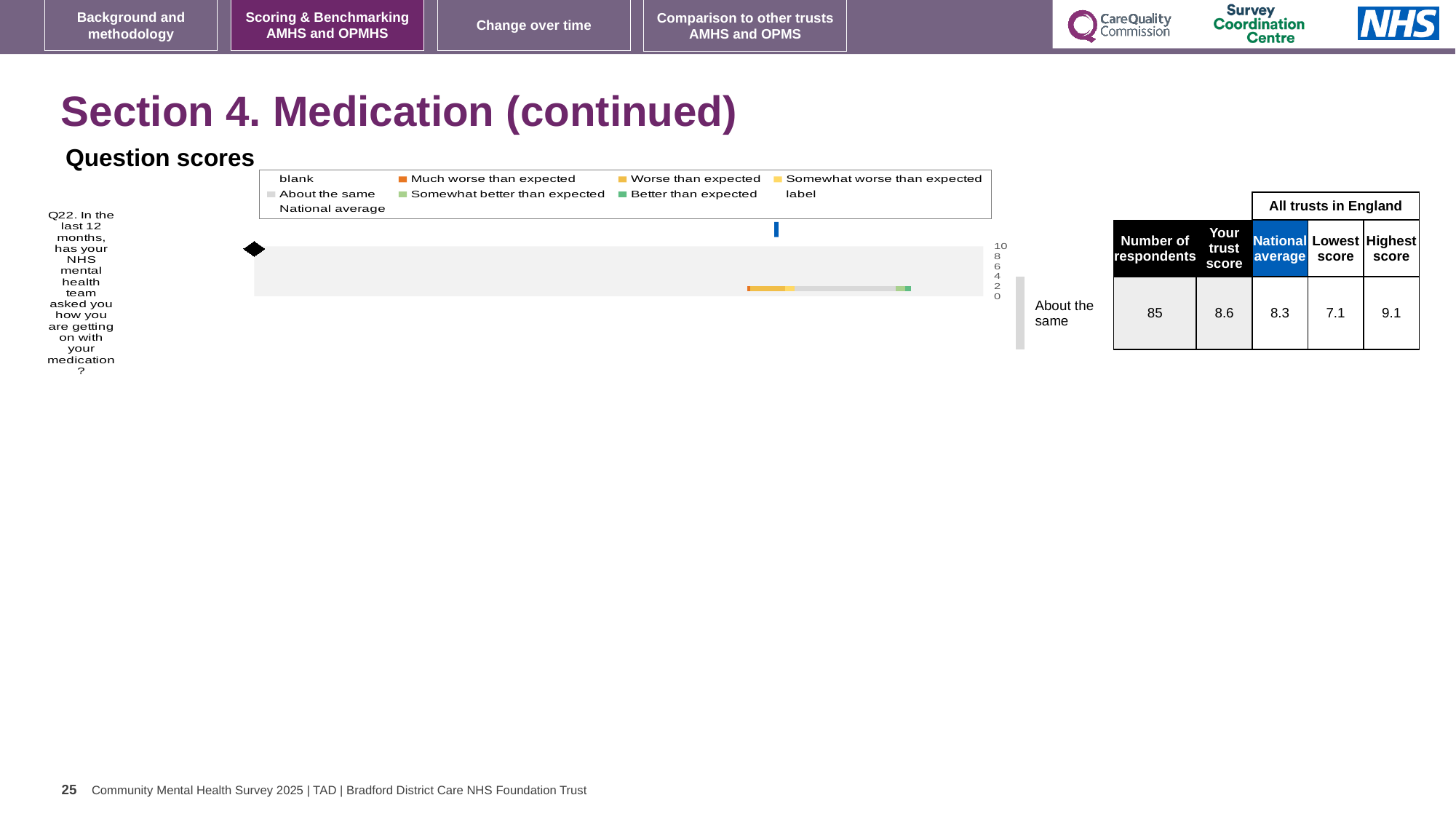
What is the trust score for Q22 shown in the table? 8.6 What is the highest score among all trusts in England for Q22? 9.1 Which benchmark category is Q22 assigned to, as labelled next to the chart? About the same Which legend entry is shown in orange? Much worse than expected How many questions (categories) are plotted in the chart? 1 Is the trust score for Q22 greater or less than 8 on the chart's axis? greater What is the lowest score among all trusts in England for Q22? 7.1 Which is larger for Q22, the trust score or the national average? the trust score How many respondents answered Q22? 85 What is the difference between the highest score and the lowest score for Q22? 2.0 What kind of chart is shown on the slide for Q22? bar chart What is the national average for Q22? 8.3